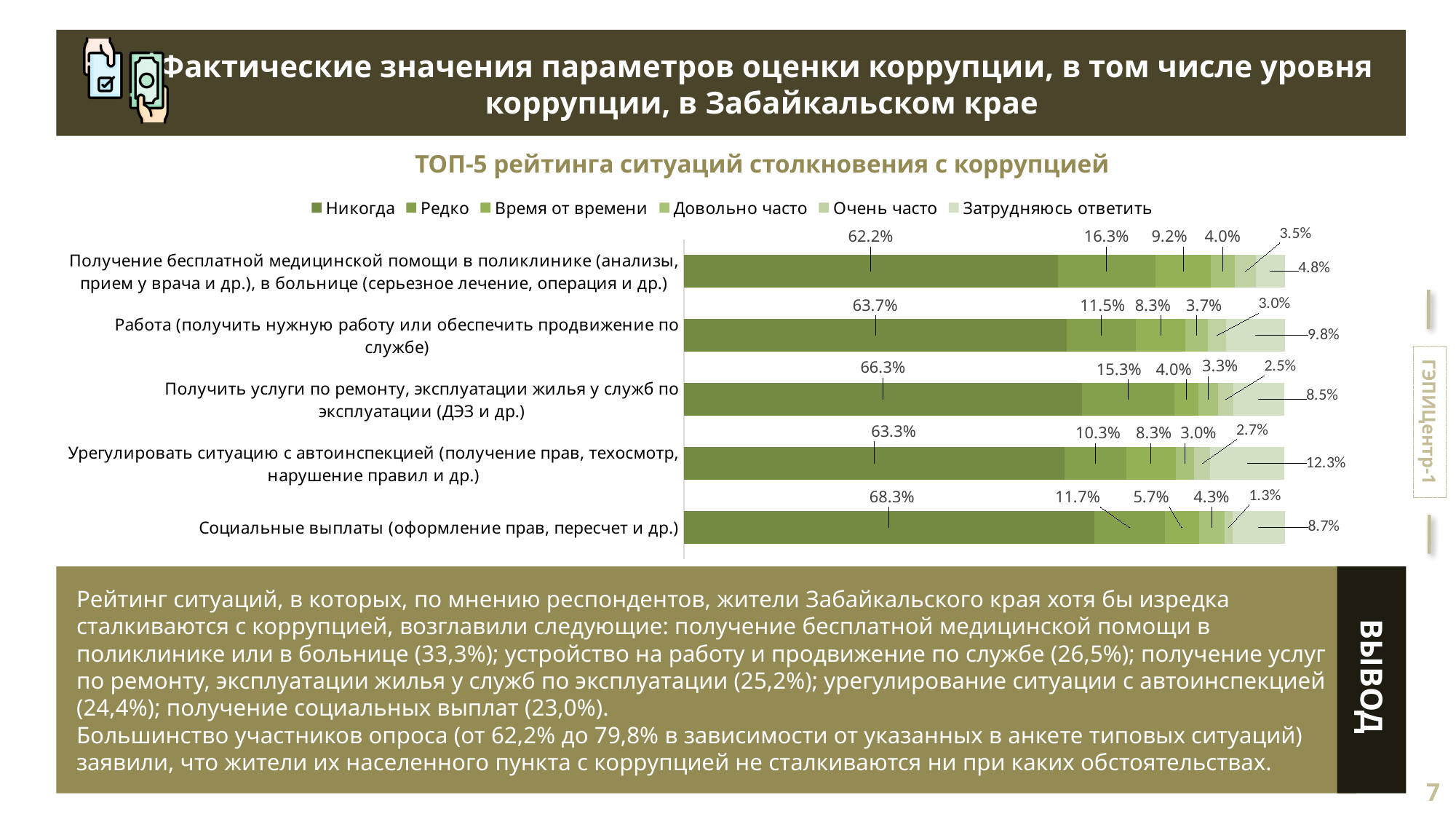
What is the 'Время от времени' value for 'Работа (получить нужную работу или обеспечить продвижение по службе)'? 8.3% Which is larger: the 'Редко' value for 'Получить услуги по ремонту...' or for 'Урегулировать ситуацию с автоинспекцией...'? Получить услуги по ремонту, эксплуатации жилья у служб по эксплуатации (ДЭЗ и др.) What is the difference between the 'Никогда' values for 'Социальные выплаты' and 'Получение бесплатной медицинской помощи'? 6.1% How many series does the legend list? 6 What is the 'Затрудняюсь ответить' value for 'Урегулировать ситуацию с автоинспекцией...'? 12.3% Which category has the highest 'Никогда' value? Социальные выплаты (оформление прав, пересчет и др.) What type of chart is shown on the slide? Stacked bar chart What is the 'Редко' value for 'Получение бесплатной медицинской помощи в поликлинике...'? 16.3% What is the 'Никогда' value for 'Социальные выплаты (оформление прав, пересчет и др.)'? 68.3% Which category has the lowest 'Никогда' value? Получение бесплатной медицинской помощи в поликлинике (анализы, прием у врача и др.), в больнице (серьезное лечение, операция и др.) How many categories (situations) are shown in the chart? 5 What is the title of the chart? ТОП-5 рейтинга ситуаций столкновения с коррупцией